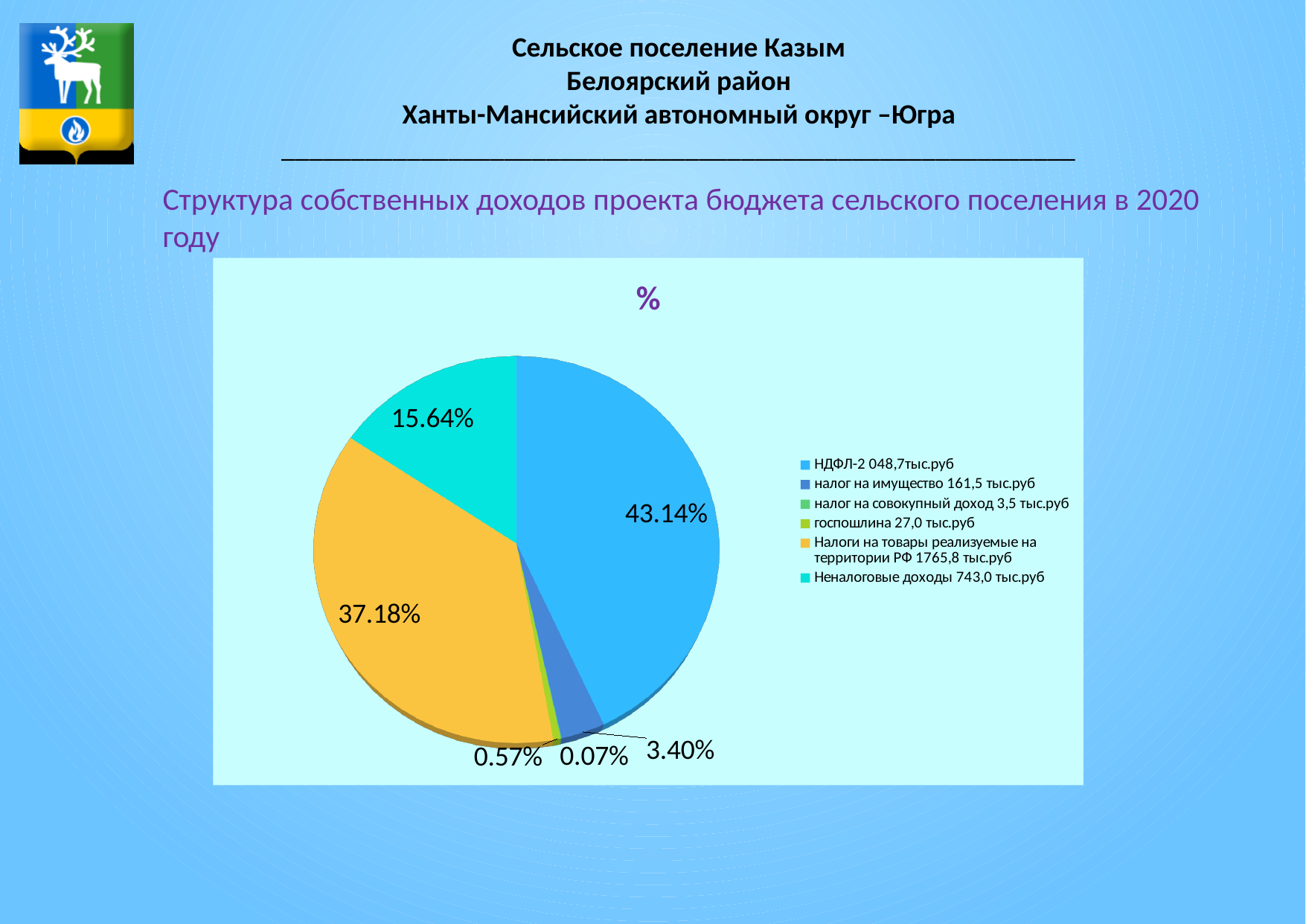
What share of the pie does налог на имущество (161,5 тыс.руб) have? 3.40% Which is larger: the share for Неналоговые доходы or the share for налог на имущество? Неналоговые доходы What share of the pie does НДФЛ (2 048,7 тыс.руб) have? 43.14% Which category has the largest share of the pie? НДФЛ-2 048,7тыс.руб What kind of chart is shown on the slide? pie chart What is the difference in percentage points between the НДФЛ share and the Налоги на товары share? 5.96 What share of the pie does госпошлина (27,0 тыс.руб) have? 0.57% What is the title of the pie chart? % Which category has the smallest share of the pie? налог на совокупный доход 3,5 тыс.руб How many slices does the pie chart have? 6